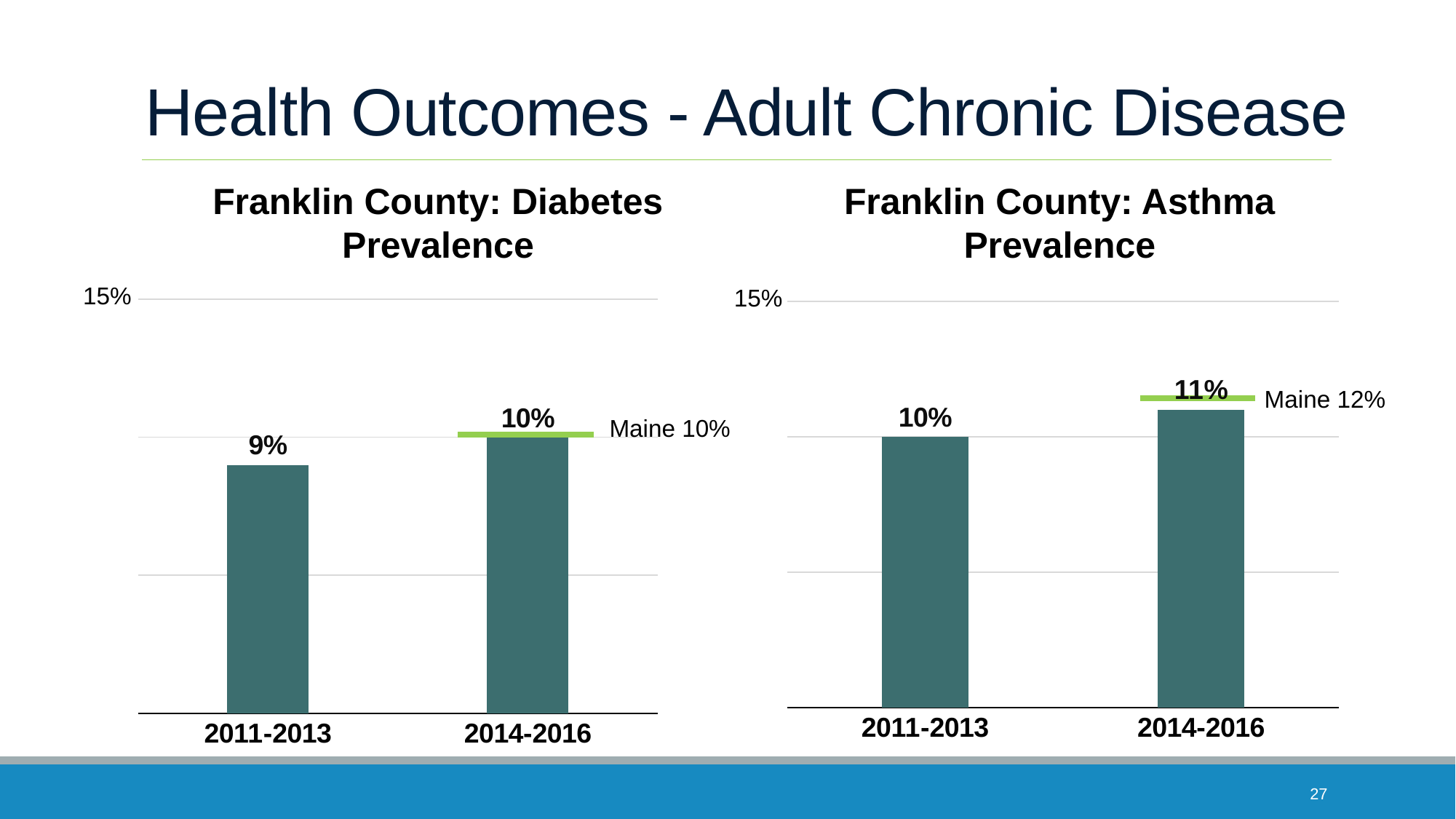
In the Franklin County: Diabetes Prevalence chart, what is the value for 2014-2016? 10% In the Franklin County: Asthma Prevalence chart, what is the value for 2011-2013? 10% In the Franklin County: Diabetes Prevalence chart, what is the value for 2011-2013? 9% In the Franklin County: Diabetes Prevalence chart, what Maine value is marked by the green line? 10% In the Franklin County: Asthma Prevalence chart, what is the value for 2014-2016? 11% In the Franklin County: Asthma Prevalence chart, what is the difference between the 2014-2016 and 2011-2013 values? 1% How many periods are shown on the x axis of the Franklin County: Asthma Prevalence chart? 2 In the Franklin County: Diabetes Prevalence chart, do the values rise or fall from 2011-2013 to 2014-2016? rise What kind of chart is the Franklin County: Diabetes Prevalence chart? bar chart In the Franklin County: Diabetes Prevalence chart, which period has the higher value? 2014-2016 In the Franklin County: Asthma Prevalence chart, which period has the lower value? 2011-2013 In the Franklin County: Asthma Prevalence chart, what Maine value is marked by the green line? 12%